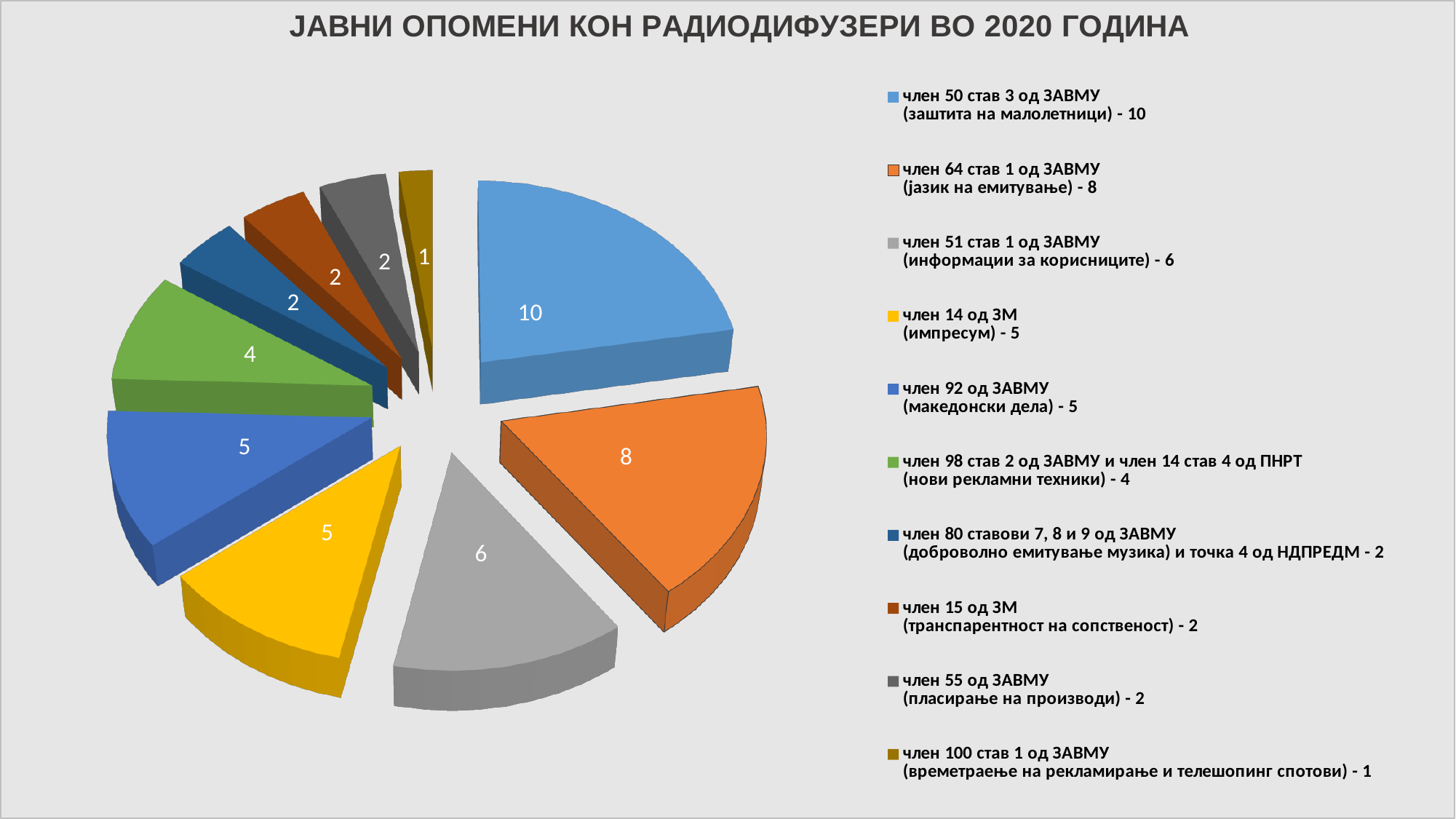
What type of chart is shown on the slide? pie chart What is the difference between the value for "член 50 став 3 од ЗАВМУ" and the value for "член 64 став 1 од ЗАВМУ"? 2 How many categories does the pie chart have? 10 What is the title of the chart? ЈАВНИ ОПОМЕНИ КОН РАДИОДИФУЗЕРИ ВО 2020 ГОДИНА Which category has the largest slice of the pie? член 50 став 3 од ЗАВМУ (заштита на малолетници) What is the value for "член 51 став 1 од ЗАВМУ (информации за корисниците)"? 6 What is the total of all the values shown in the pie chart? 45 Which category has the smallest slice of the pie? член 100 став 1 од ЗАВМУ (времетраење на рекламирање и телешопинг спотови) What is the value for "член 64 став 1 од ЗАВМУ (јазик на емитување)"? 8 What is the value for "член 98 став 2 од ЗАВМУ и член 14 став 4 од ПНРТ (нови рекламни техники)"? 4 Which is larger: the value for "член 14 од ЗМ (импресум)" or the value for "член 55 од ЗАВМУ (пласирање на производи)"? член 14 од ЗМ (импресум) What is the value for "член 50 став 3 од ЗАВМУ (заштита на малолетници)"? 10